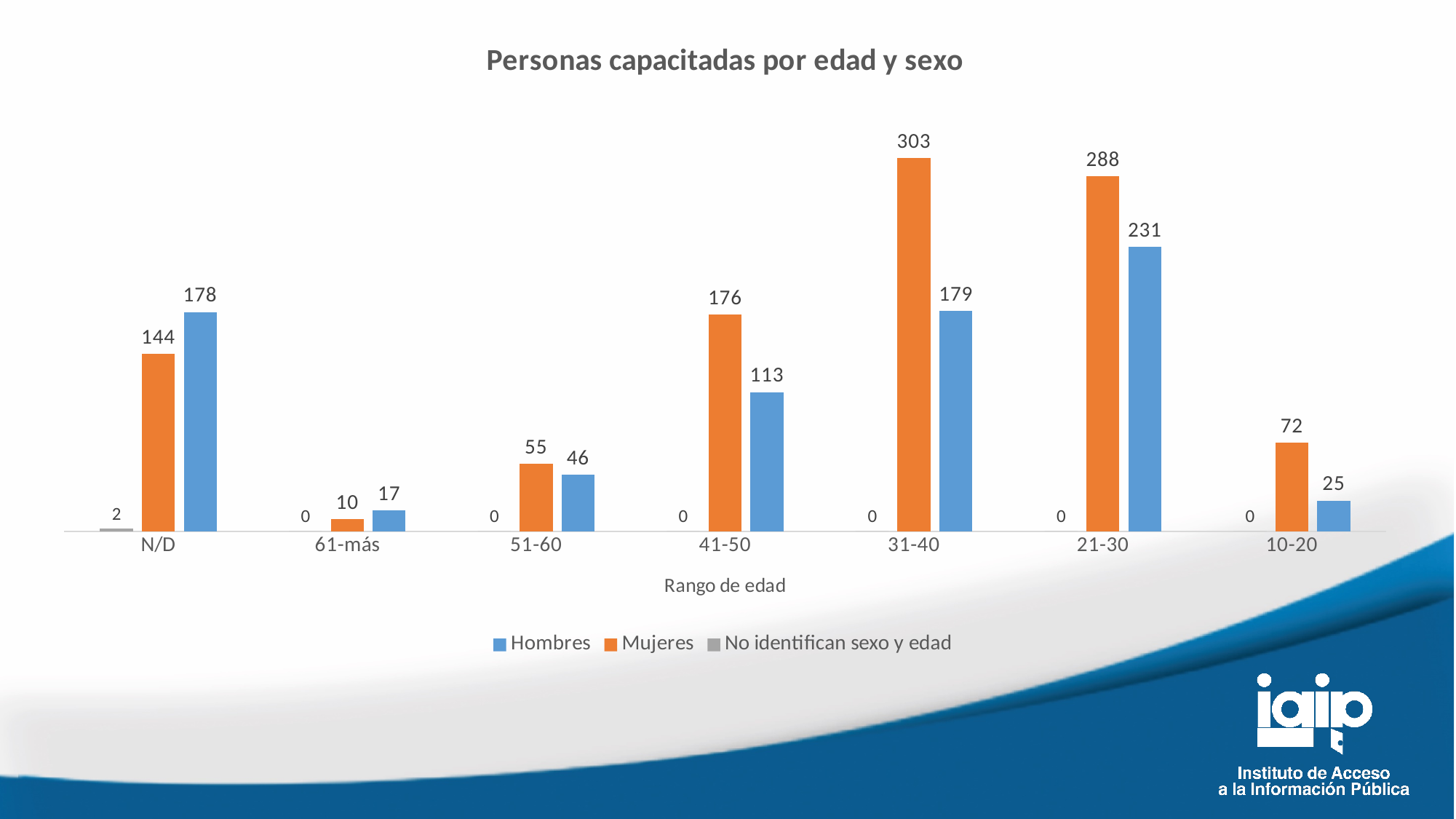
What is the value for Mujeres in the 31-40 age range? 303 How many series does the legend list? 3 Which age range has the lowest value for Hombres? 61-más What is the value for No identifican sexo y edad in the N/D category? 2 In the N/D category, which is larger, Hombres or Mujeres? Hombres Which age range has the highest value for Mujeres? 31-40 What is the difference between Mujeres and Hombres in the 41-50 age range? 63 How many age range categories are shown on the x axis? 7 What kind of chart is shown on the slide? Bar chart What is the value for Hombres in the 21-30 age range? 231 In the 51-60 age range, which is larger, Mujeres or Hombres? Mujeres What is the title of the chart? Personas capacitadas por edad y sexo